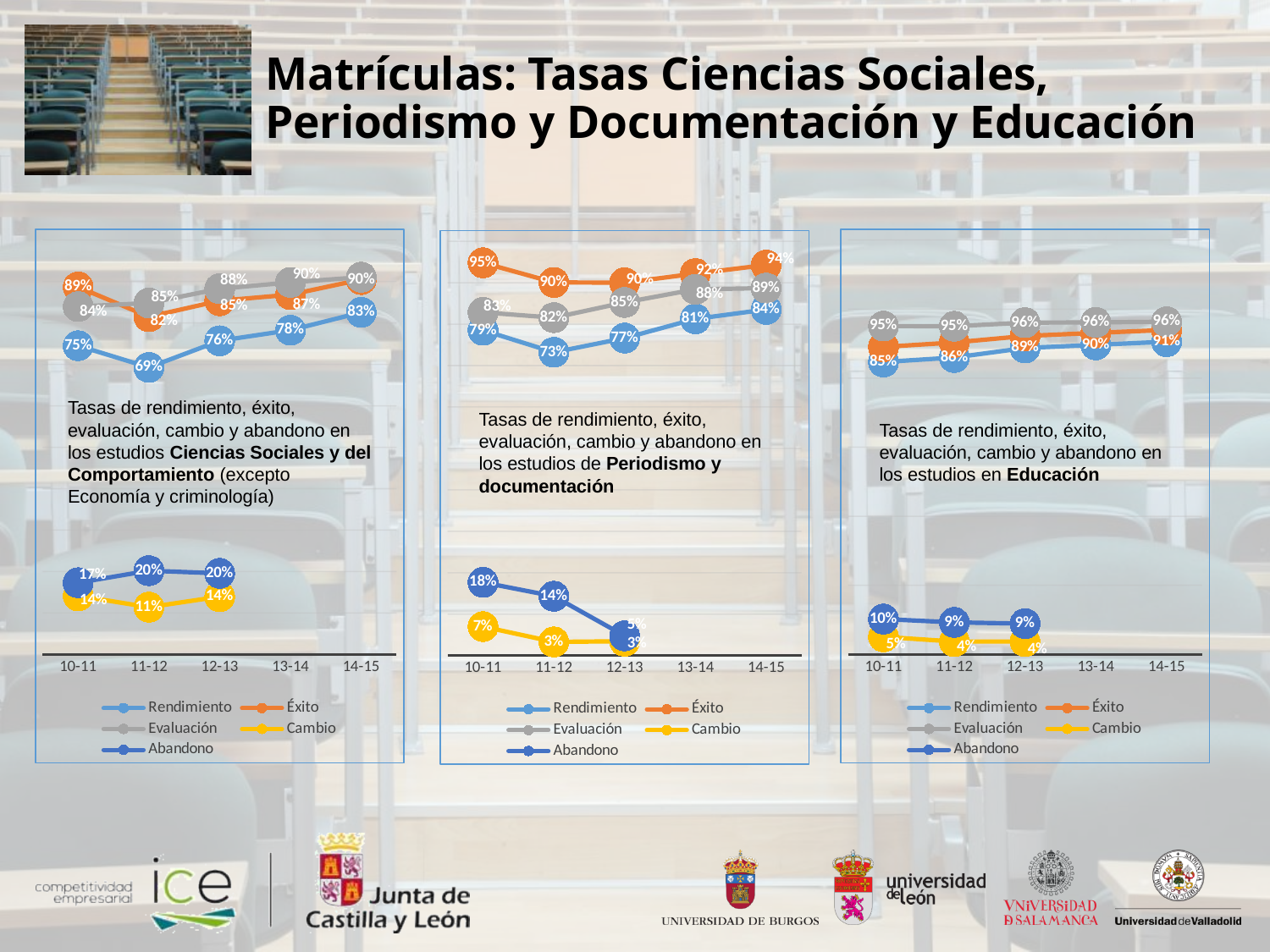
In the Periodismo y documentación chart, what is the Éxito value for 10-11? 95% In the Educación chart, what is the Evaluación value for 14-15? 96% In the Ciencias Sociales y del Comportamiento chart, what is the Éxito value for 14-15? 90% In the Ciencias Sociales y del Comportamiento chart, which year has the lowest Rendimiento value? 11-12 How many series does the legend of the Educación chart list? 5 In the Periodismo y documentación chart, what is the Abandono value for 10-11? 18% In the Periodismo y documentación chart, does the Abandono value rise or fall from 10-11 to 12-13? fall In the Educación chart, what is the Abandono value for 10-11? 10% In the Ciencias Sociales y del Comportamiento chart, what is the Rendimiento value for 11-12? 69% What kind of chart is the Periodismo y documentación chart? line chart In the Periodismo y documentación chart, what is the difference between the Rendimiento values for 14-15 and 10-11? 5% In the Ciencias Sociales y del Comportamiento chart, what is the difference between the Abandono and Cambio values for 12-13? 6%